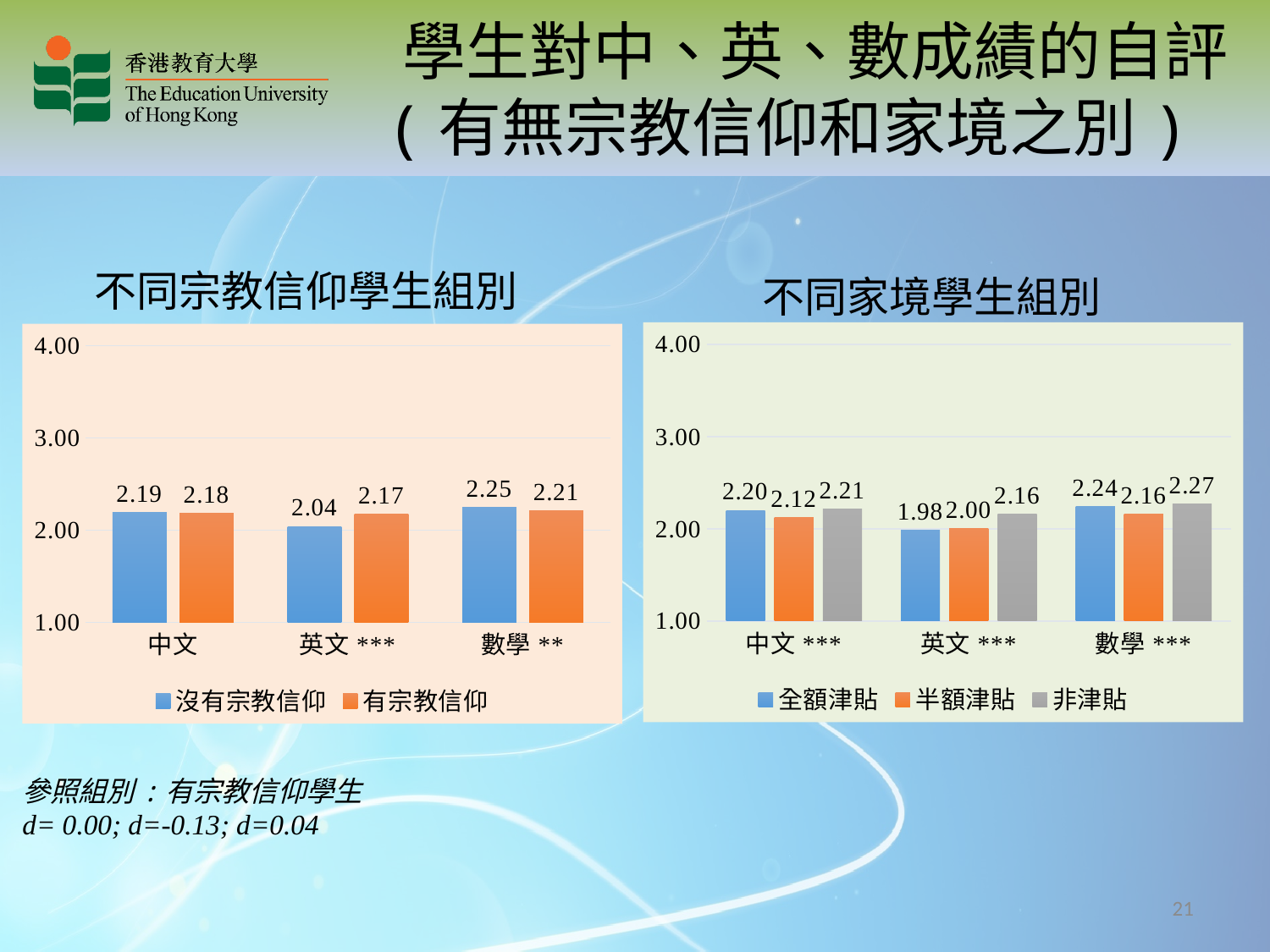
In the right chart (不同家境學生組別), what is the value for 全額津貼 in 英文? 1.98 In the left chart (不同宗教信仰學生組別), what is the difference between 有宗教信仰 and 沒有宗教信仰 in 英文? 0.13 In the left chart (不同宗教信仰學生組別), which subject has the lowest value for 沒有宗教信仰? 英文 In the right chart (不同家境學生組別), is the value for 全額津貼 in 英文 greater or less than 2.00? less In the left chart (不同宗教信仰學生組別), how many series does the legend list? 2 In the right chart (不同家境學生組別), how many series does the legend list? 3 In the left chart (不同宗教信仰學生組別), what is the value for 有宗教信仰 in 數學? 2.21 What type of chart is the right chart (不同家境學生組別)? Bar chart In the right chart (不同家境學生組別), what is the difference between 非津貼 and 半額津貼 in 數學? 0.11 In the left chart (不同宗教信仰學生組別), what is the value for 沒有宗教信仰 in 英文? 2.04 In the right chart (不同家境學生組別), what is the value for 非津貼 in 數學? 2.27 In the right chart (不同家境學生組別), which series has the highest value in 英文? 非津貼